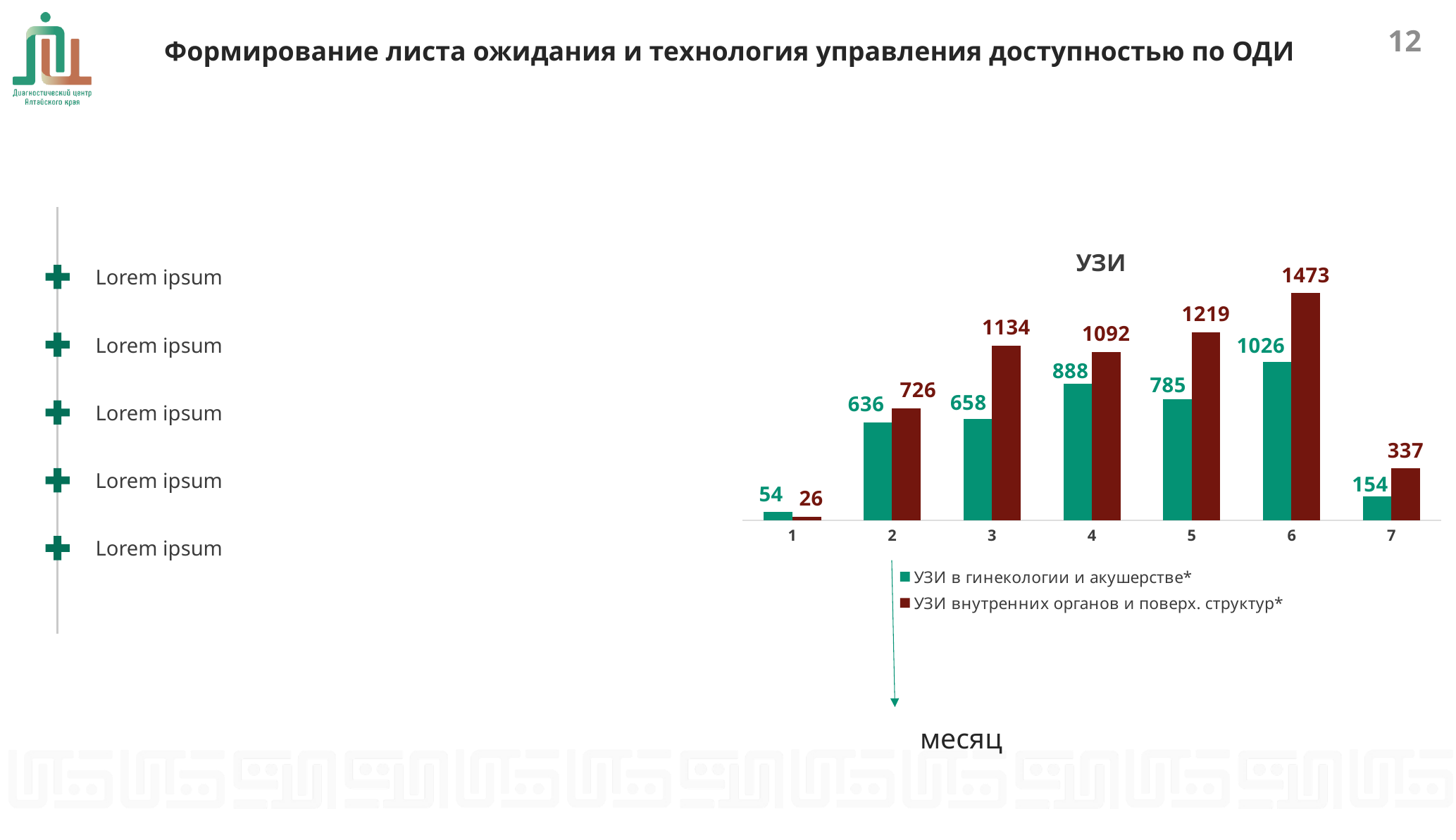
In month 1, which series has the larger value? УЗИ в гинекологии и акушерстве* How many months are shown on the x axis of the chart? 7 How many series does the legend list? 2 Which month has the lowest value in the series 'УЗИ внутренних органов и поверх. структур*'? 1 What is the difference between the two series in month 3? 476 What is the value for month 1 in the series 'УЗИ внутренних органов и поверх. структур*'? 26 What is the value for month 4 in the series 'УЗИ в гинекологии и акушерстве*'? 888 Which month has the highest value in the series 'УЗИ в гинекологии и акушерстве*'? 6 In month 5, which series has the larger value? УЗИ внутренних органов и поверх. структур* What is the value for month 6 in the series 'УЗИ внутренних органов и поверх. структур*'? 1473 What type of chart is shown on the slide? Bar chart What is the difference between month 6 and month 7 in the series 'УЗИ в гинекологии и акушерстве*'? 872